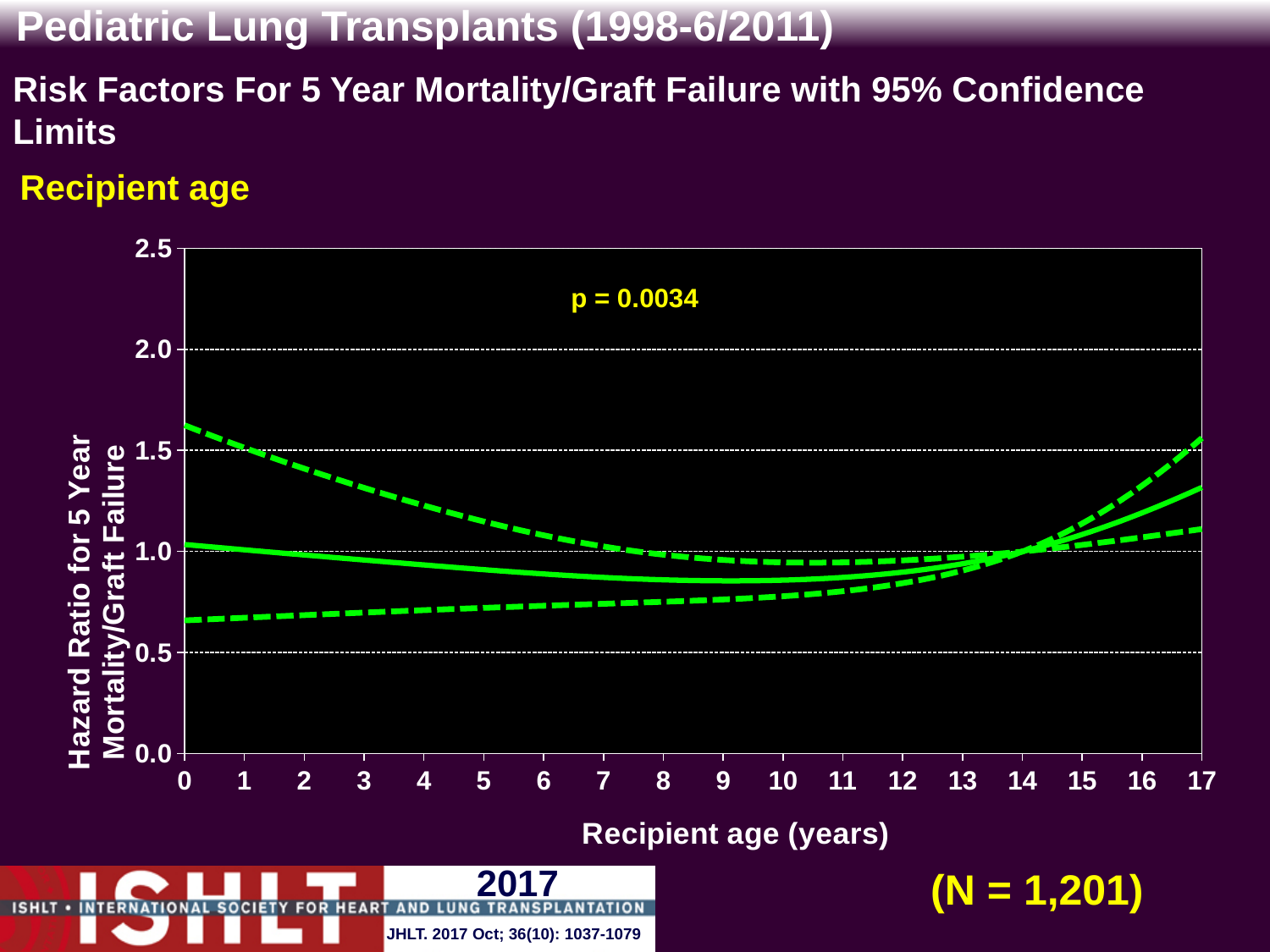
Does the hazard ratio (solid line) rise or fall as recipient age increases from 10 to 17 years? rise How many tick labels are shown on the x axis (recipient age)? 18 Is the hazard ratio (solid line) at recipient age 17 years greater or less than 1.0? greater What sample size (N) is shown on the slide? N = 1,201 What kind of chart is shown on the slide? line chart Does the hazard ratio (solid line) rise or fall as recipient age increases from 0 to 9 years? fall Is the lower 95% confidence limit (lower dashed line) at recipient age 0 greater or less than 0.5? greater What p-value is printed on the chart? p = 0.0034 Is the upper 95% confidence limit (upper dashed line) at recipient age 0 greater or less than 1.5? greater How many lines are plotted on the chart? 3